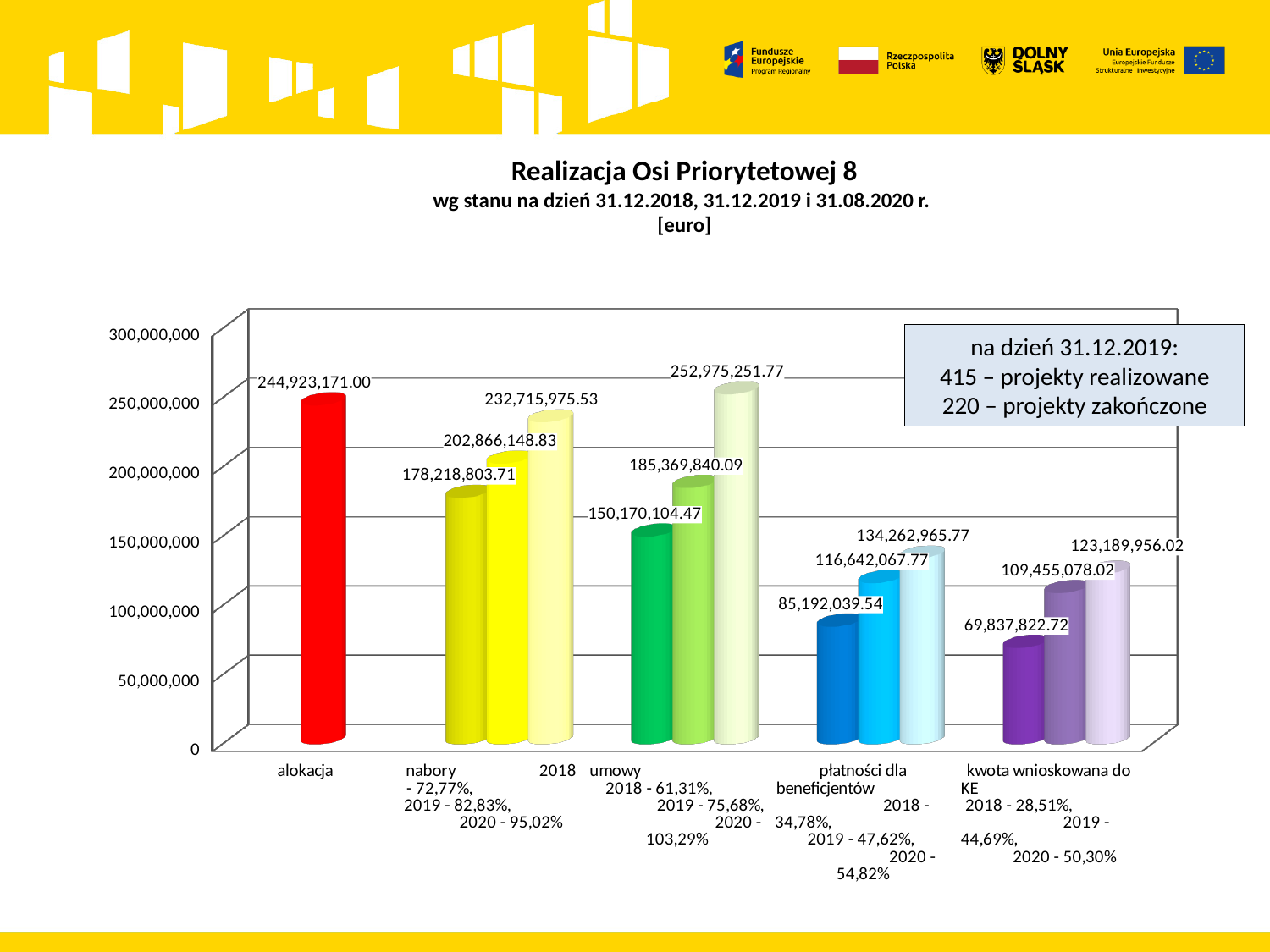
What is the 2019 value for kwota wnioskowana do KE? 109,455,078.02 How many categories are shown on the x axis? 5 Do the values for płatności dla beneficjentów rise or fall from 2018 to 2020? rise What is the difference between the 2020 and 2018 values for umowy? 102,805,147.30 Which is larger: the 2019 value for nabory or the 2019 value for umowy? nabory 2019 (202,866,148.83) Which bar on the chart has the lowest value? kwota wnioskowana do KE 2018 (69,837,822.72) What type of chart is shown on the slide? bar chart What is the 2020 value for umowy? 252,975,251.77 Which bar on the chart has the highest value? umowy 2020 (252,975,251.77) What is the 2020 value for nabory? 232,715,975.53 What is the value of the alokacja bar? 244,923,171.00 What is the 2018 value for płatności dla beneficjentów? 85,192,039.54